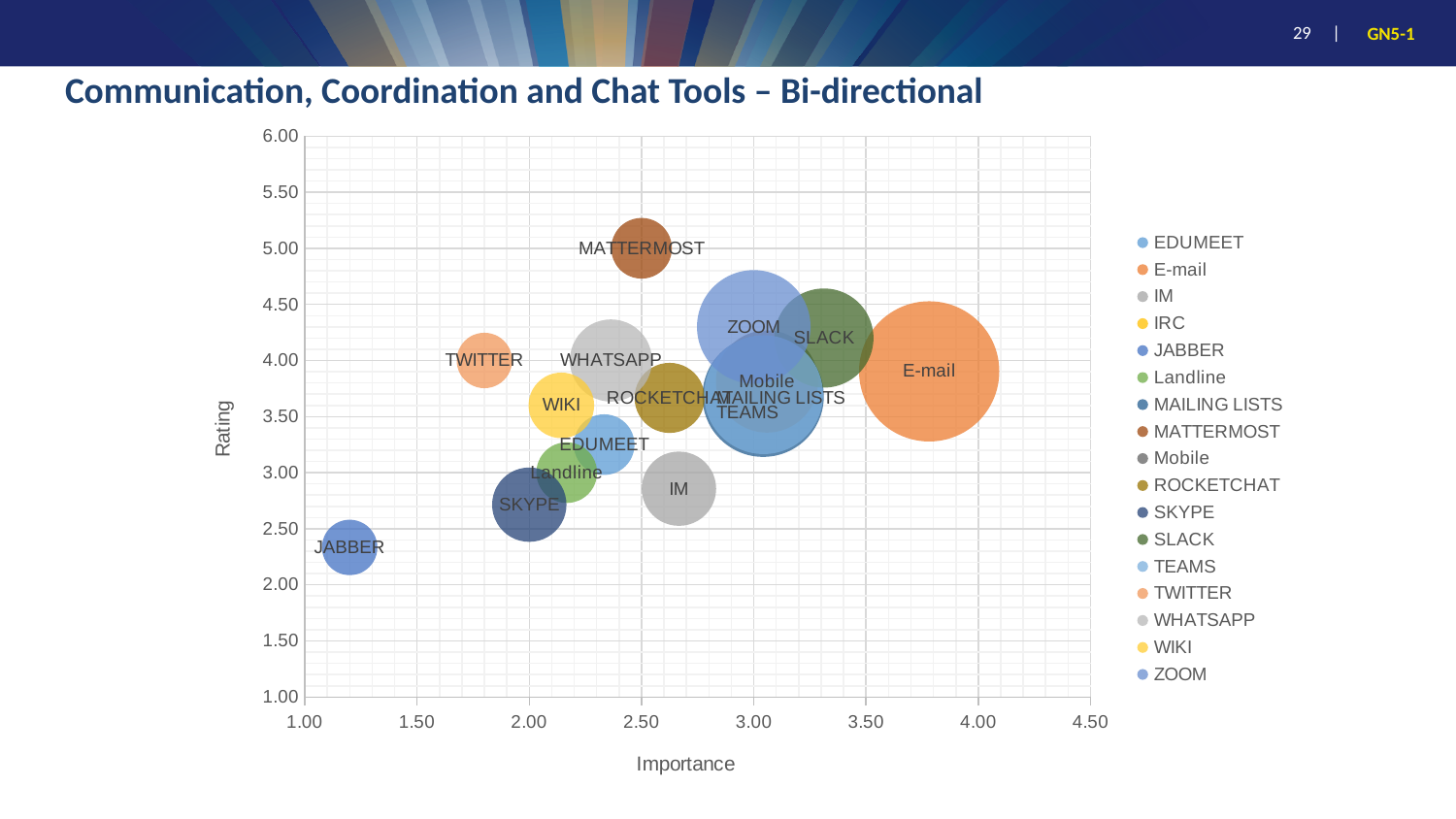
Is the Rating for MATTERMOST greater or less than 4.50? greater Which tool has the highest Rating? MATTERMOST What kind of chart is shown on the slide? Bubble chart Which has the higher Rating, MATTERMOST or E-mail? MATTERMOST What is the label of the vertical axis? Rating Is the Importance for TWITTER greater or less than 2.00? less Which tool has the highest Importance? E-mail Which tool has the lowest Importance? JABBER Is the Importance for E-mail greater or less than 3.50? greater How many tools does the legend list? 17